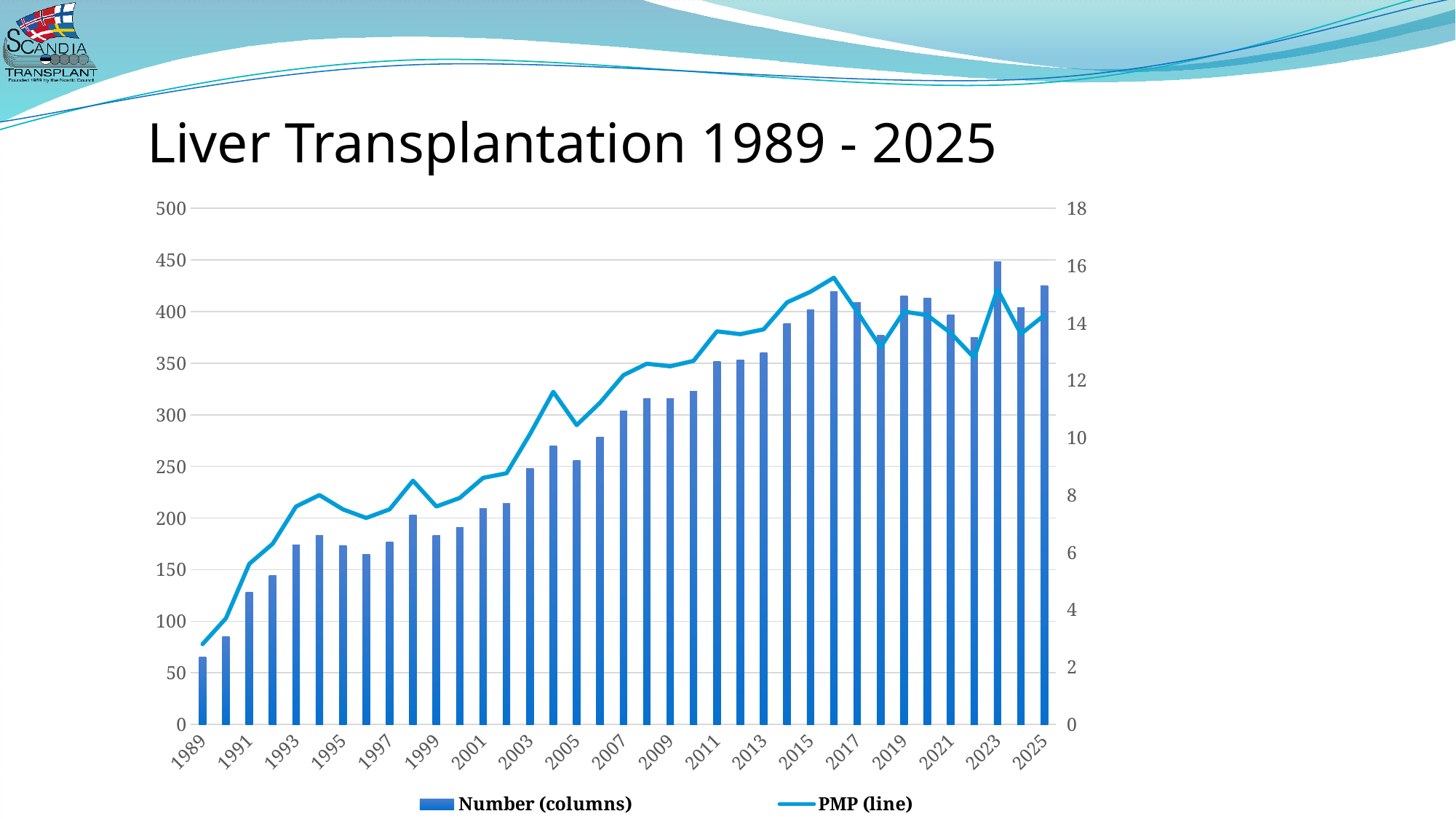
Is the Number (columns) value for 2023 greater or less than 400? greater Is the Number (columns) value for 2009 greater or less than 300? greater Overall, do the Number (columns) values rise or fall from 1989 to 2025? rise How many series does the legend list? 2 Is the Number (columns) value for 1989 greater or less than 100? less Which year has the highest bar for Number (columns)? 2023 How many years (bars) are plotted on the chart? 37 Which year has the lowest bar for Number (columns)? 1989 What kind of chart is shown on the slide? A combined bar and line chart